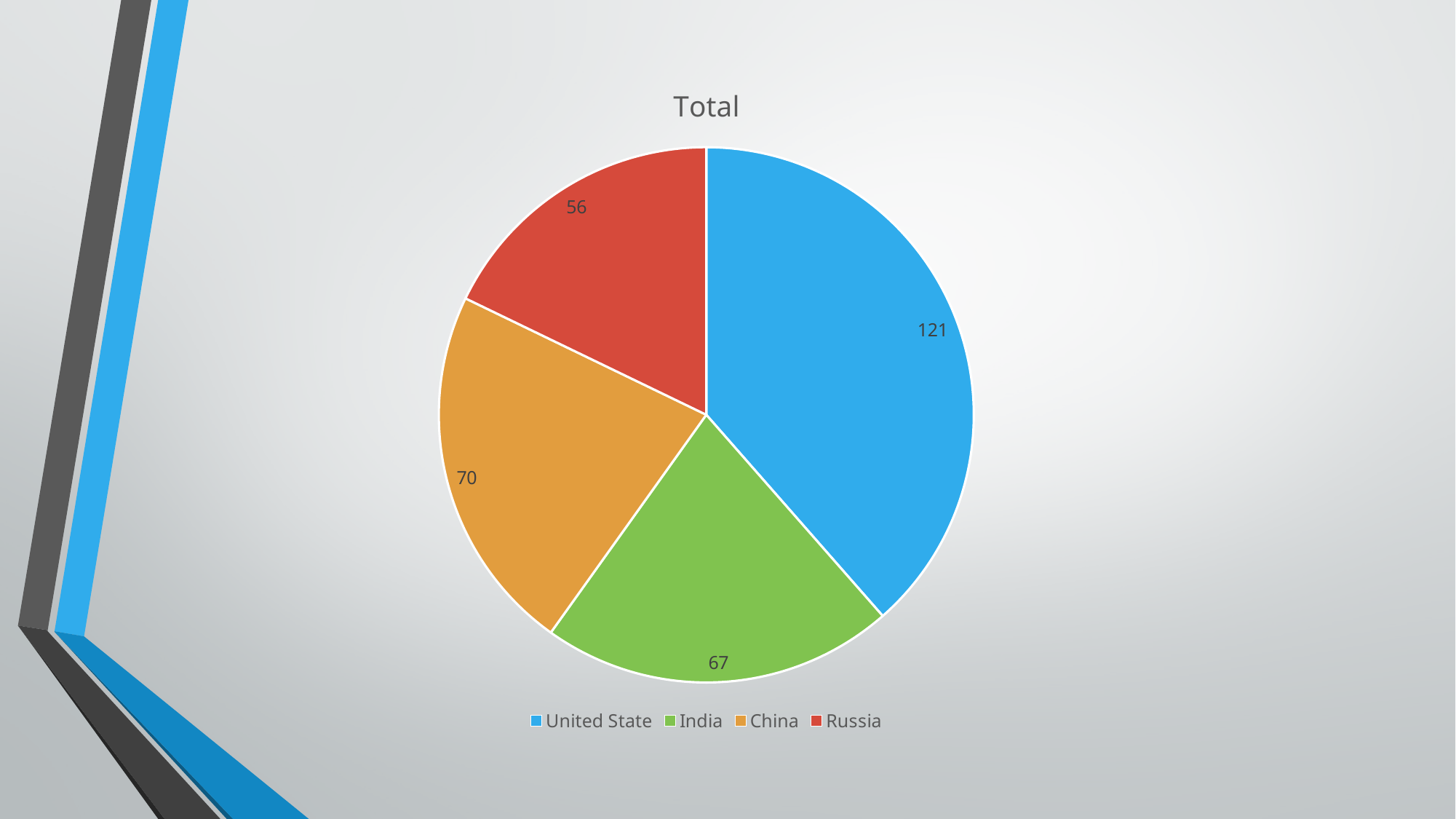
Which is larger, the value for China or the value for India? China Which category has the largest slice? United State How many slices does the pie chart have? 4 What kind of chart is shown on the slide? Pie chart What is the difference between the values for United State and India? 54 What is the value for United State? 121 What is the title of the chart? Total What is the value for Russia? 56 What is the total of all the slices in the pie chart? 314 What is the value for China? 70 Which category has the smallest slice? Russia What colour is the slice for India? Green